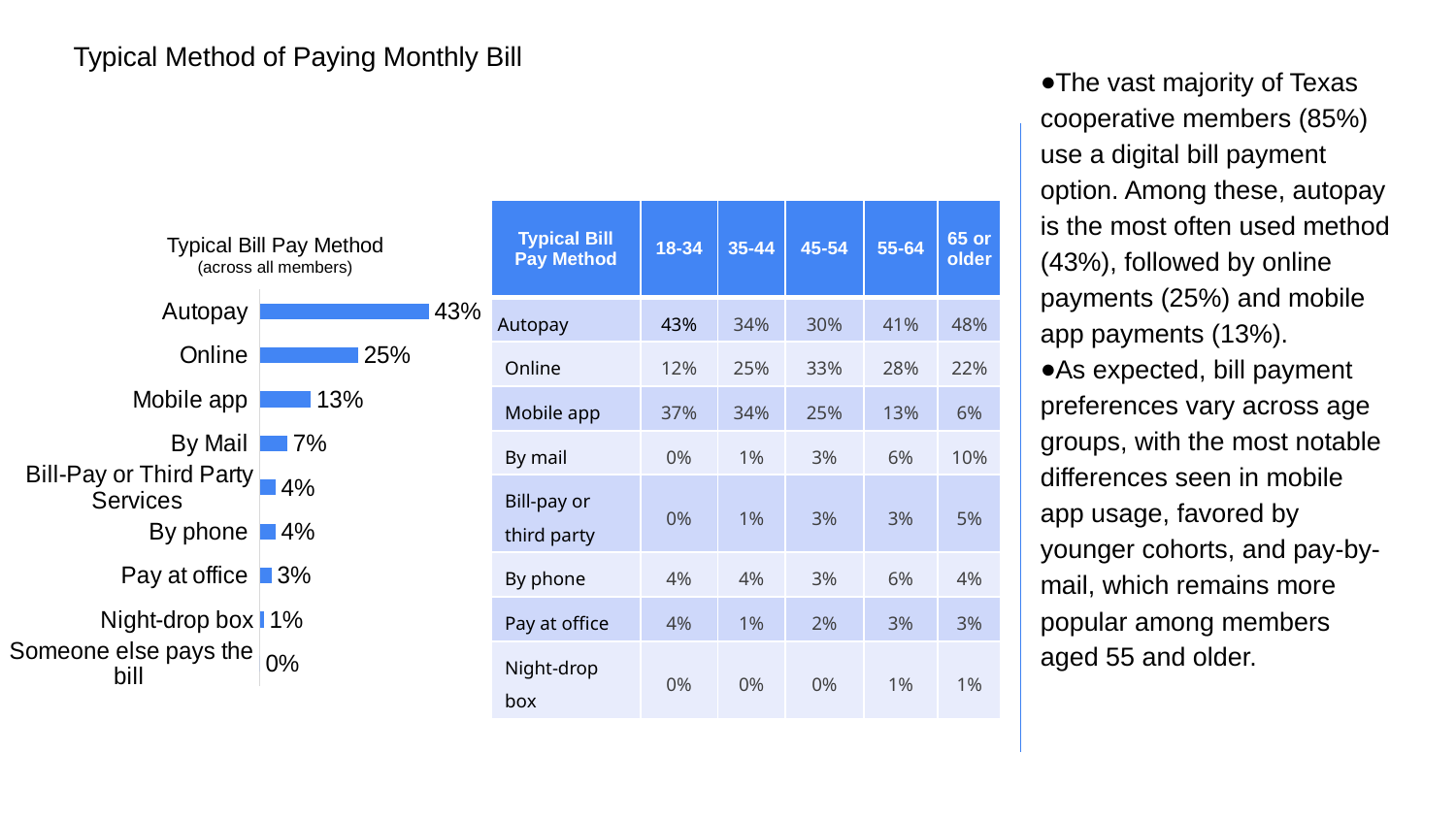
In the 'Typical Bill Pay Method' chart, what is the difference between the values for Autopay and Online? 18% In the 'Typical Bill Pay Method' chart, which is larger, the value for Online or the value for Mobile app? Online How many categories are shown in the 'Typical Bill Pay Method' chart? 9 In the 'Typical Bill Pay Method' chart, what is the value for Night-drop box? 1% In the 'Typical Bill Pay Method' chart, what is the value for Autopay? 43% In the 'Typical Bill Pay Method' chart, which category has the highest value? Autopay What is the subtitle shown under the 'Typical Bill Pay Method' chart title? (across all members) In the 'Typical Bill Pay Method' chart, what is the value for Mobile app? 13% In the 'Typical Bill Pay Method' chart, what is the value for By Mail? 7% In the 'Typical Bill Pay Method' chart, what is the value for Online? 25% In the 'Typical Bill Pay Method' chart, which category has the lowest value? Someone else pays the bill What kind of chart is the 'Typical Bill Pay Method (across all members)' chart? bar chart